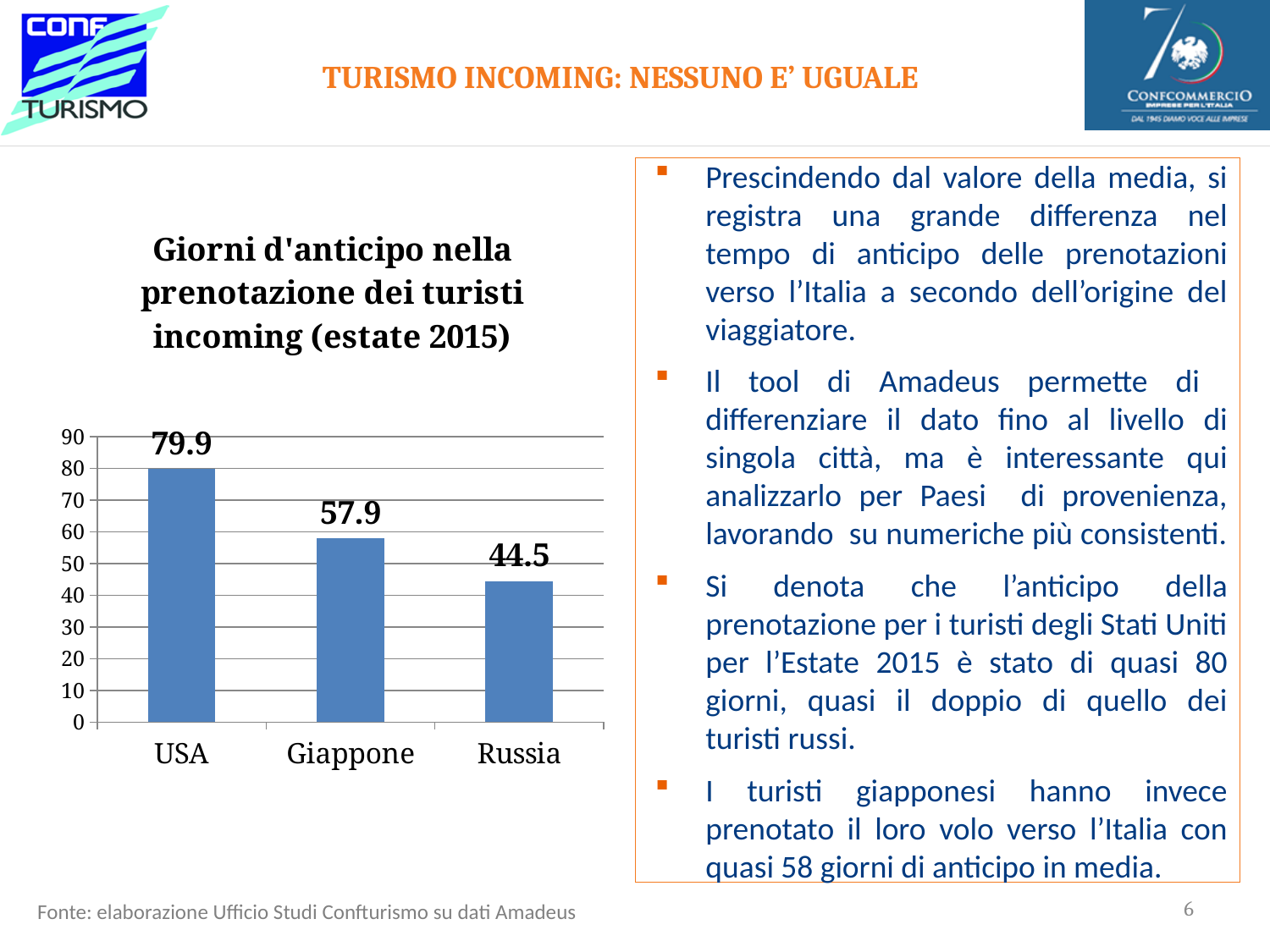
Which category has the lowest value? Russia What is the difference between the values for USA and Russia? 35.4 What is the value for Russia? 44.5 What is the value for USA? 79.9 Which is larger, the value for Giappone or the value for Russia? Giappone What is the title of the chart? Giorni d'anticipo nella prenotazione dei turisti incoming (estate 2015) How many categories are shown on the x axis? 3 What kind of chart is shown on the slide? bar chart Which category has the highest value? USA What is the difference between the values for USA and Giappone? 22.0 What is the value for Giappone? 57.9 Is the value for Russia greater or less than 50? less